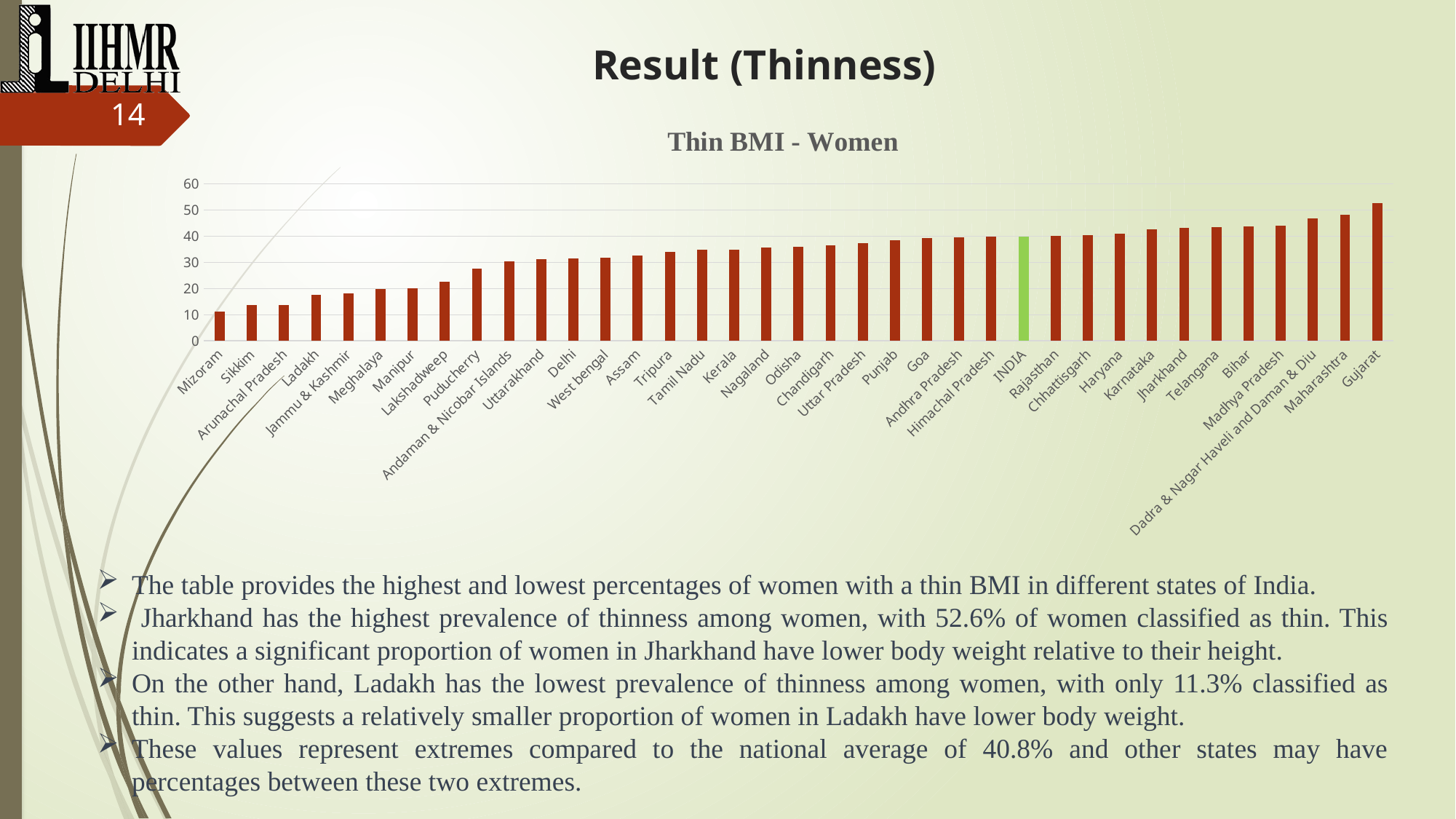
What is the title of the chart? Thin BMI - Women Which has a larger value, Ladakh or Kerala? Kerala Which category has the highest bar in the chart? Gujarat Is the value for Puducherry greater or less than 30? less Do the bar values rise or fall moving from left to right along the x axis? Rise Is the value for Maharashtra greater or less than 40? greater Is the value for Gujarat greater or less than 50? greater Which category has the lowest bar in the chart? Mizoram What kind of chart is shown on the slide? Bar chart Which category's bar is coloured green instead of red? INDIA Which has a larger value, Delhi or Sikkim? Delhi